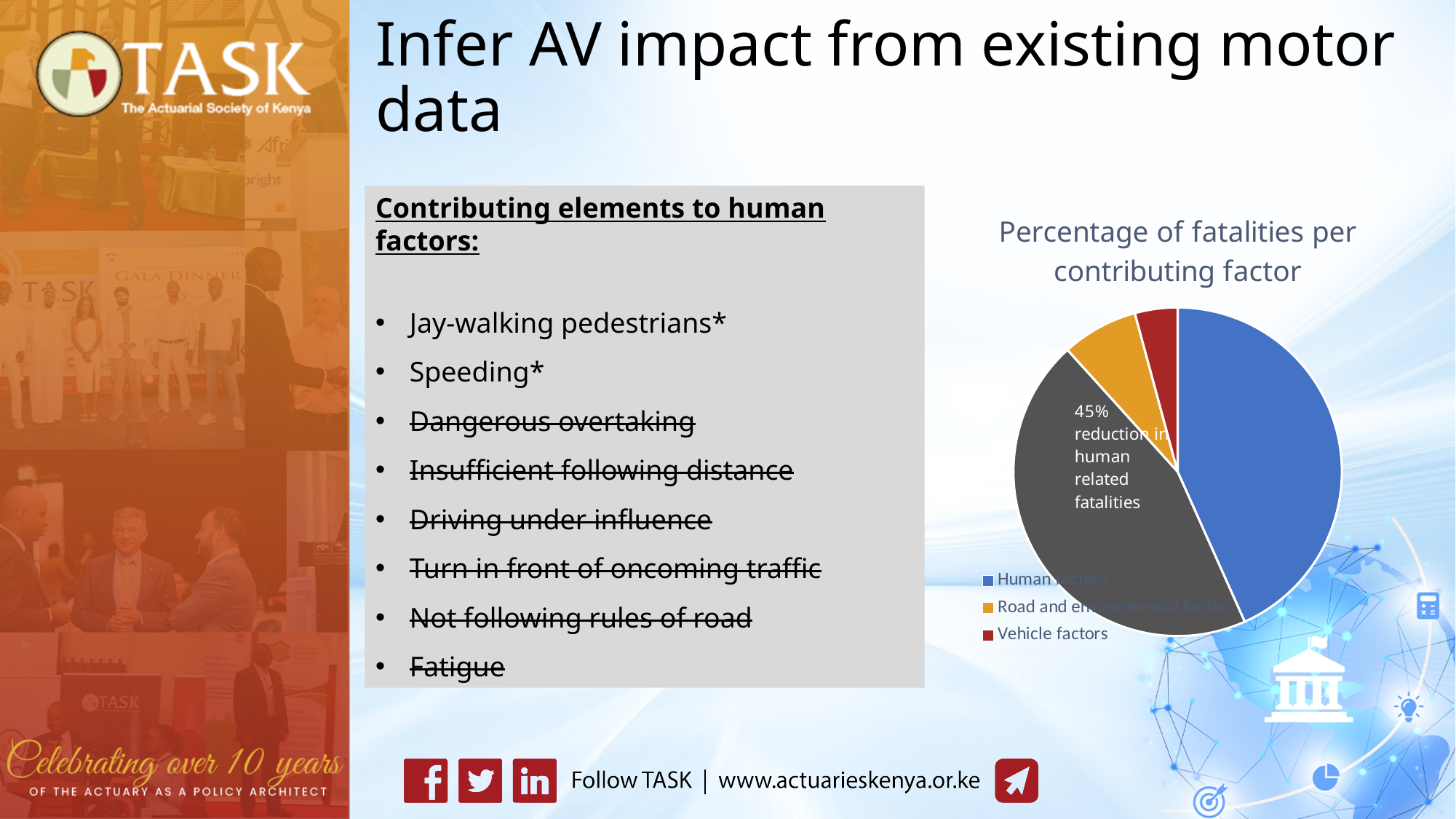
Which slice is larger in the pie chart: Road and environmental factors or Vehicle factors? Road and environmental factors What is the title of the pie chart? Percentage of fatalities per contributing factor Which slice is larger in the pie chart: Human factors or Road and environmental factors? Human factors How many entries does the legend of the pie chart list? 3 What kind of chart is shown on the slide? pie chart What percentage reduction in human related fatalities is annotated on the pie chart? 45% Which contributing factor has the smallest slice in the pie chart? Vehicle factors